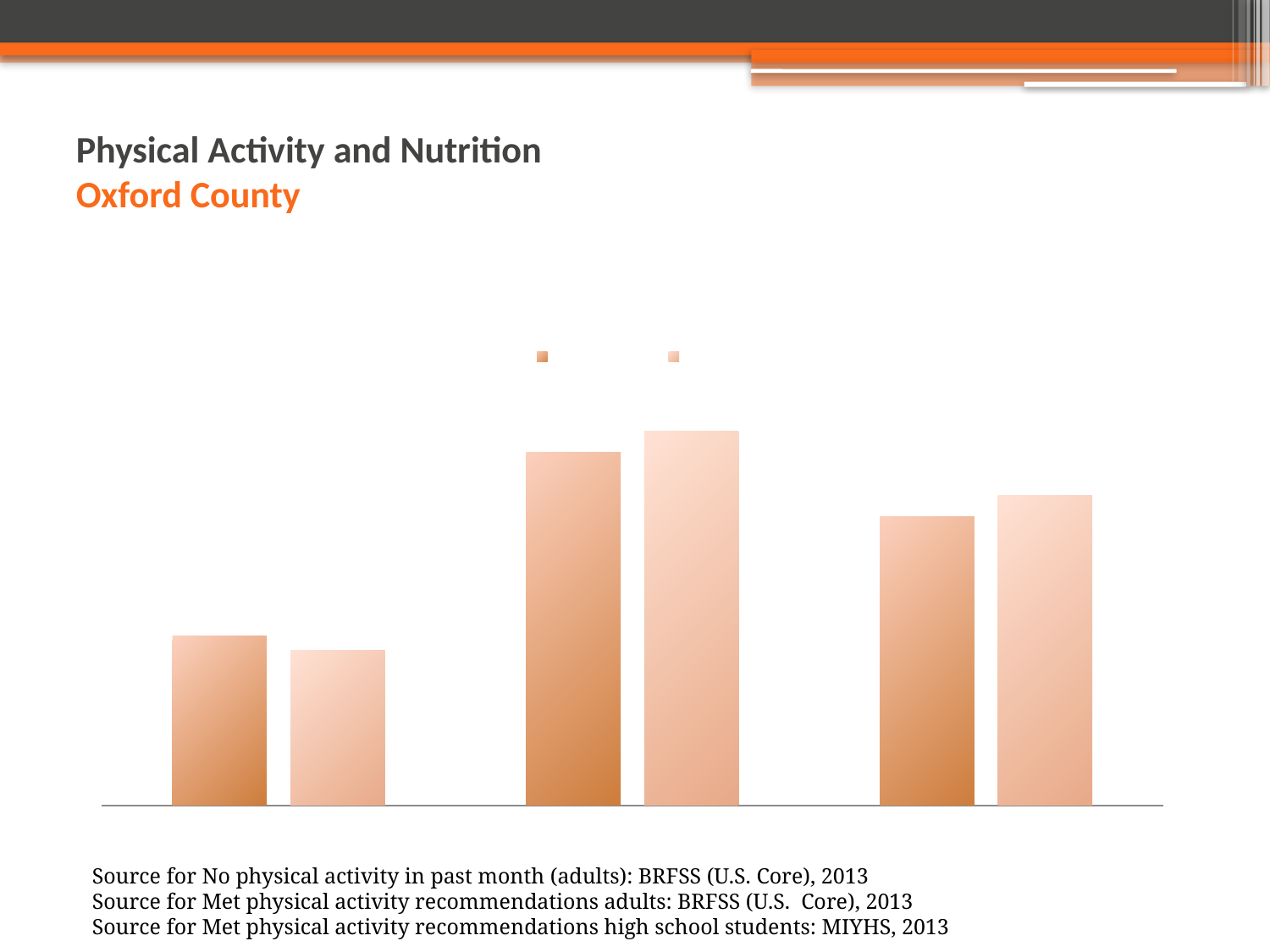
In the middle group, which bar is taller: the darker orange bar or the lighter orange bar? The lighter orange bar Which single bar on the chart is the shortest? The lighter orange bar in the left group Which group of bars has the tallest bars: the left, middle, or right group? Middle group In the leftmost group, which bar is taller: the darker orange bar or the lighter orange bar? The darker orange bar What kind of chart is shown on the slide? Bar chart In the rightmost group, which bar is taller: the darker orange bar or the lighter orange bar? The lighter orange bar How many groups of bars does the chart show? 3 Which single bar on the chart is the tallest? The lighter orange bar in the middle group How many series does the chart's legend list? 2 Which group of bars has the shortest bars: the left, middle, or right group? Left group How many bars are plotted in total on the chart? 6 What colour family are the bars on the chart? Orange